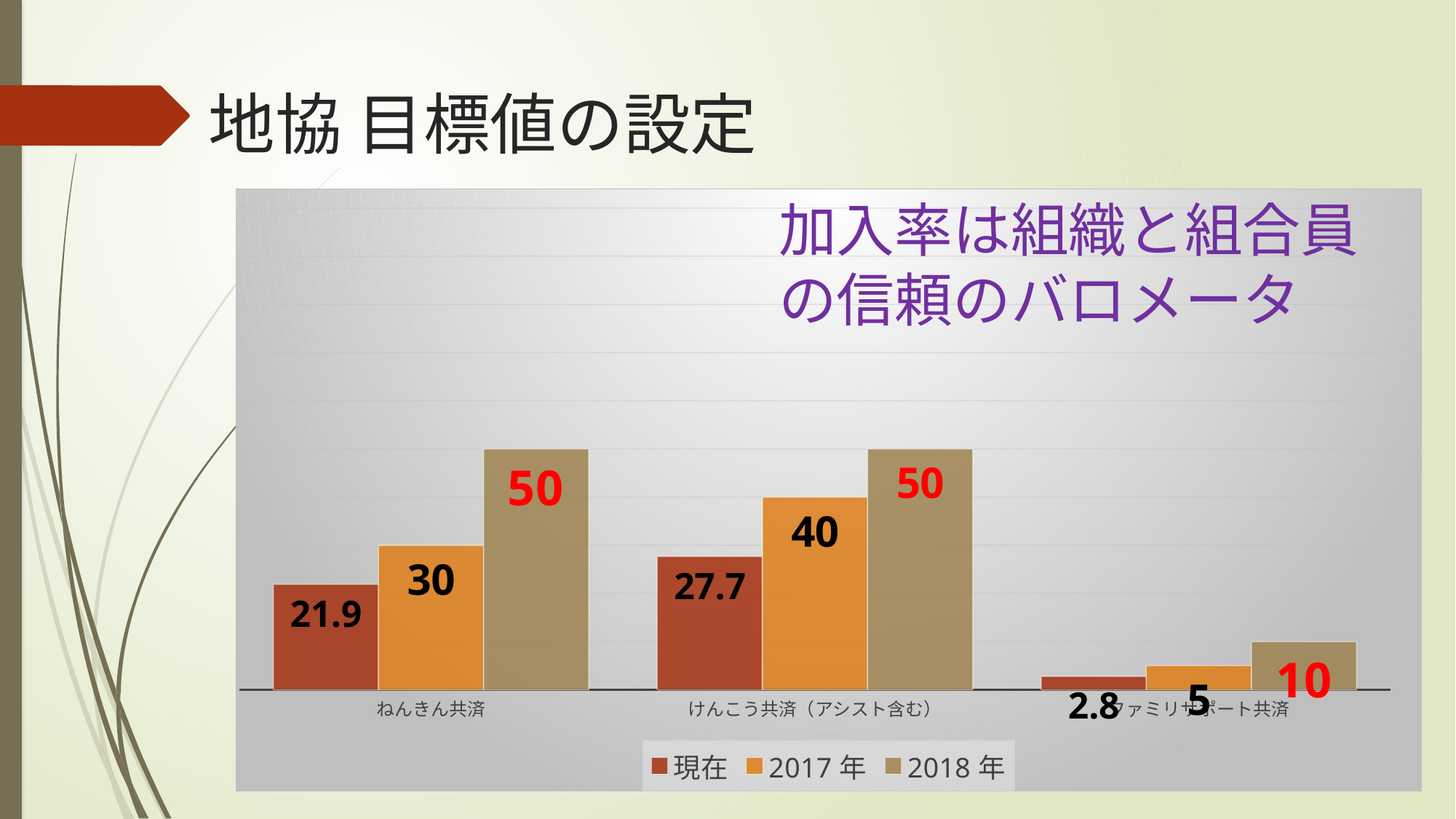
What is the difference between the 2017年 values of けんこう共済（アシスト含む） and ねんきん共済? 10 What kind of chart is shown on the slide? bar chart What is the 現在 value for ねんきん共済? 21.9 What is the 現在 value for ファミリーサポート共済? 2.8 What is the 2018年 value for ファミリーサポート共済? 10 For ねんきん共済, how much higher is the 2018年 value than the 現在 value? 28.1 Which category has the lowest 2017年 value? ファミリーサポート共済 How many series does the legend list? 3 What is the 2017年 value for けんこう共済（アシスト含む）? 40 How many categories are shown on the x axis? 3 Which category has the highest 現在 value? けんこう共済（アシスト含む） Which is larger, the 現在 value for ねんきん共済 or for けんこう共済（アシスト含む）? けんこう共済（アシスト含む）